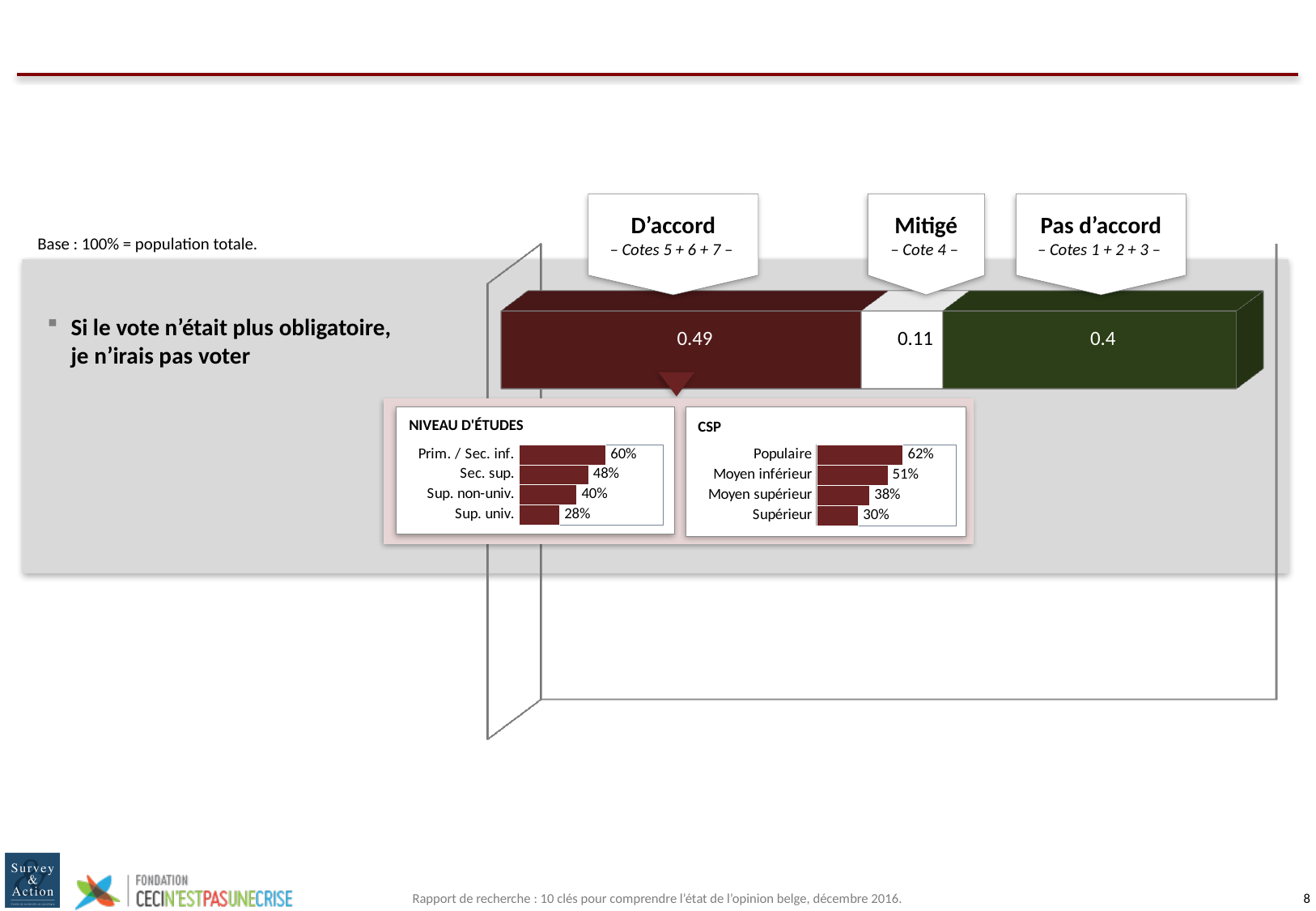
In the main stacked bar, what is the difference between 'D'accord' and 'Pas d'accord'? 0.09 In the 'CSP' chart, what is the value for 'Moyen supérieur'? 38% In the main stacked bar, which segment is the largest? D'accord In the main stacked bar, what is the value for 'Pas d'accord'? 0.4 In the main stacked bar, what is the value for 'D'accord'? 0.49 In the 'CSP' chart, which is larger: 'Moyen inférieur' or 'Supérieur'? Moyen inférieur In the 'CSP' chart, how many categories are shown? 4 In the 'NIVEAU D'ÉTUDES' chart, which category has the lowest value? Sup. univ. In the 'CSP' chart, which category has the highest value? Populaire In the main stacked bar, what is the value for 'Mitigé'? 0.11 In the 'NIVEAU D'ÉTUDES' chart, what is the difference between 'Prim. / Sec. inf.' and 'Sup. univ.'? 32% In the 'NIVEAU D'ÉTUDES' chart, what is the value for 'Sec. sup.'? 48%